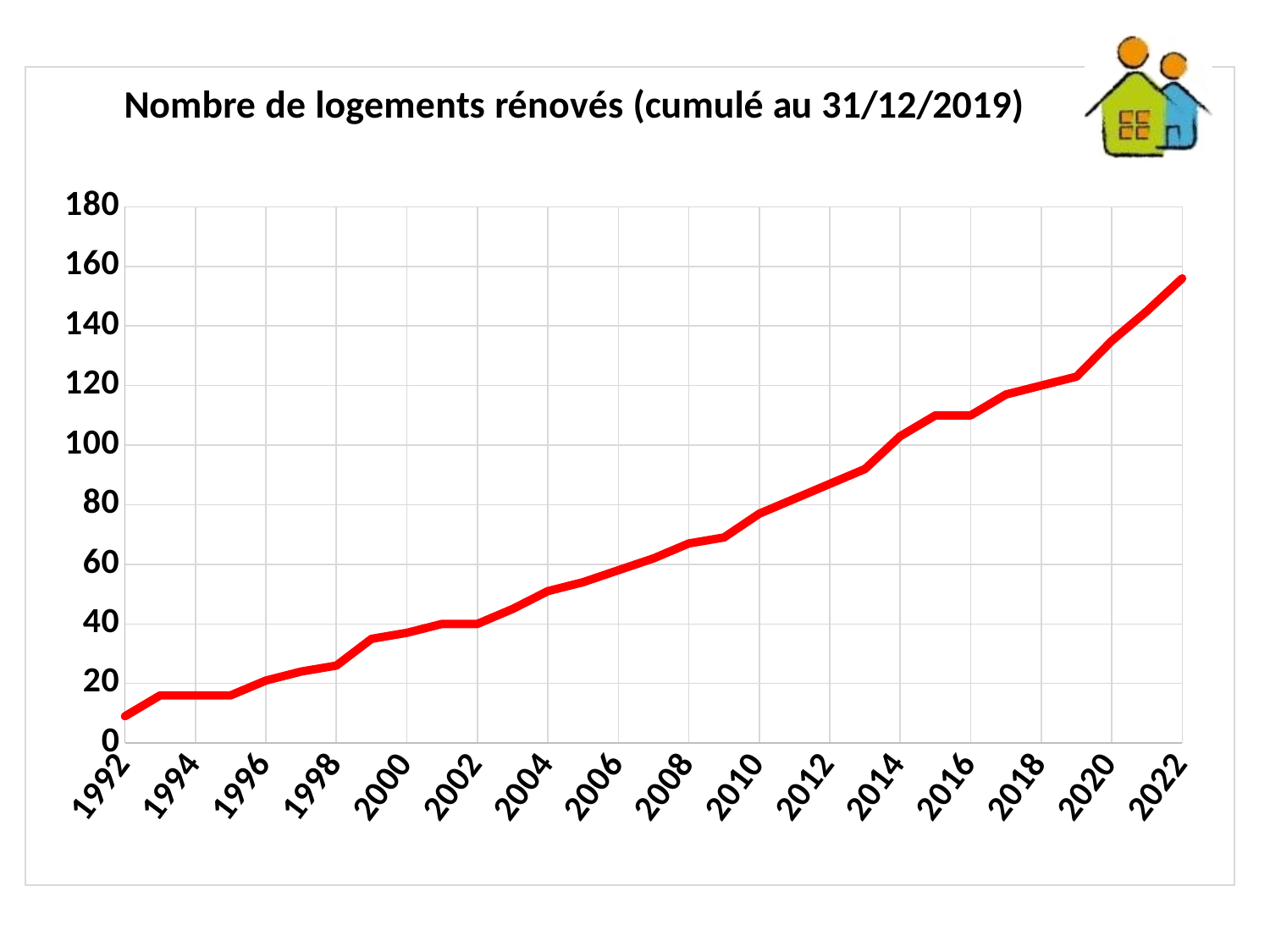
Which year has the highest value on the chart? 2022 Is the value for 2020 greater or less than 120? greater What is the title of the chart? Nombre de logements rénovés (cumulé au 31/12/2019) Is the value for 2010 greater or less than 100? less Is the value for 2022 greater or less than 140? greater Do the values rise or fall from 1992 to 2022? rise Which is larger, the value for 2012 or the value for 2004? 2012 What kind of chart is shown on the slide? line chart Which year has the lowest value on the chart? 1992